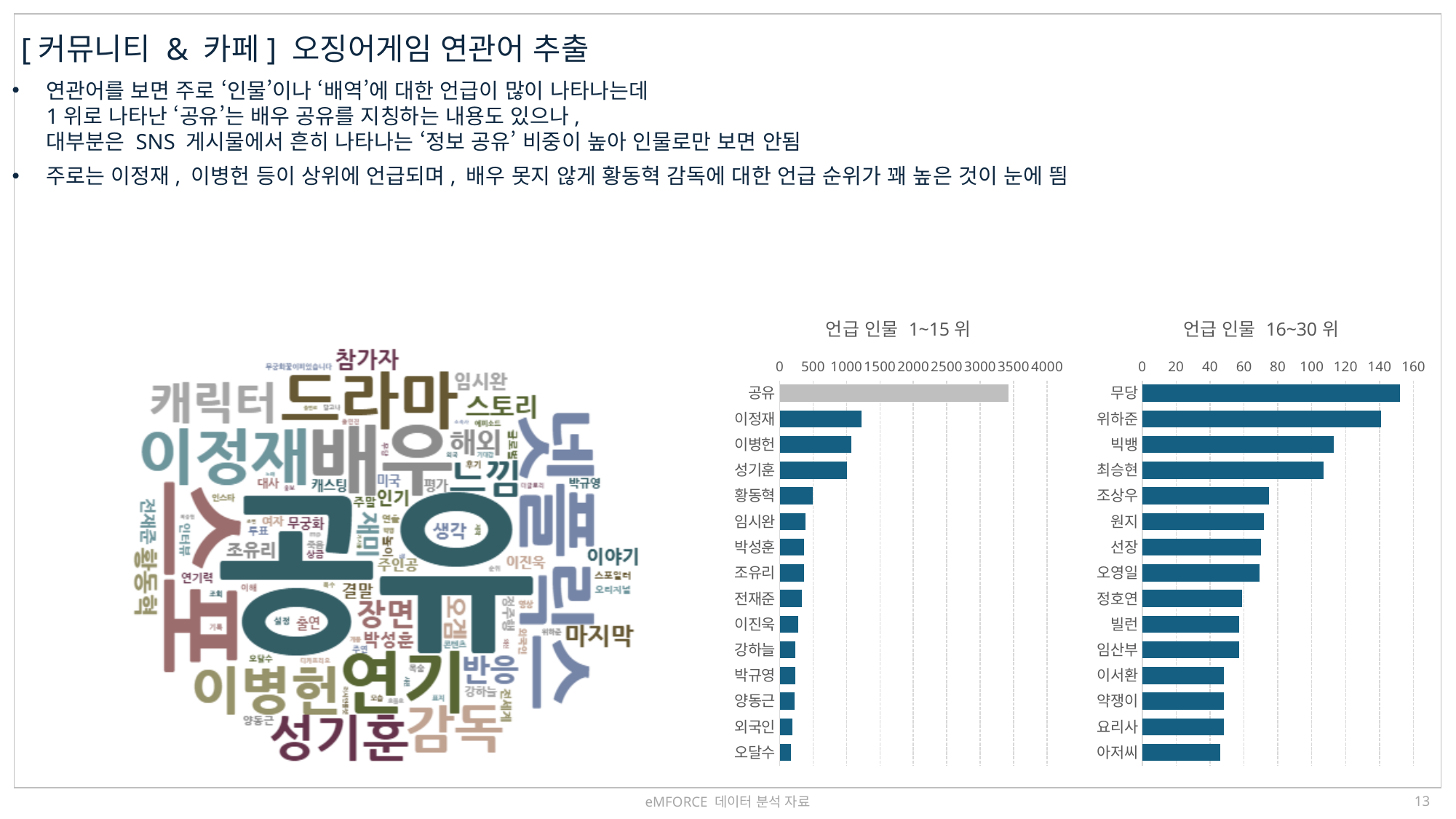
In the '언급 인물 16~30 위' chart, which category has the highest value? 무당 In the '언급 인물 16~30 위' chart, is the value for 빅뱅 greater or less than 100? greater In the '언급 인물 1~15 위' chart, which is larger, the value for 이정재 or the value for 황동혁? 이정재 In the '언급 인물 16~30 위' chart, is the value for 아저씨 greater or less than 60? less In the '언급 인물 1~15 위' chart, which category has the highest value? 공유 In the '언급 인물 1~15 위' chart, is the value for 공유 greater or less than 3000? greater How many categories are shown in the '언급 인물 1~15 위' chart? 15 In the '언급 인물 1~15 위' chart, which bar is coloured differently from the others? 공유 What kind of chart is '언급 인물 1~15 위'? bar chart In the '언급 인물 16~30 위' chart, which category has the lowest value? 아저씨 In the '언급 인물 1~15 위' chart, which category has the lowest value? 오달수